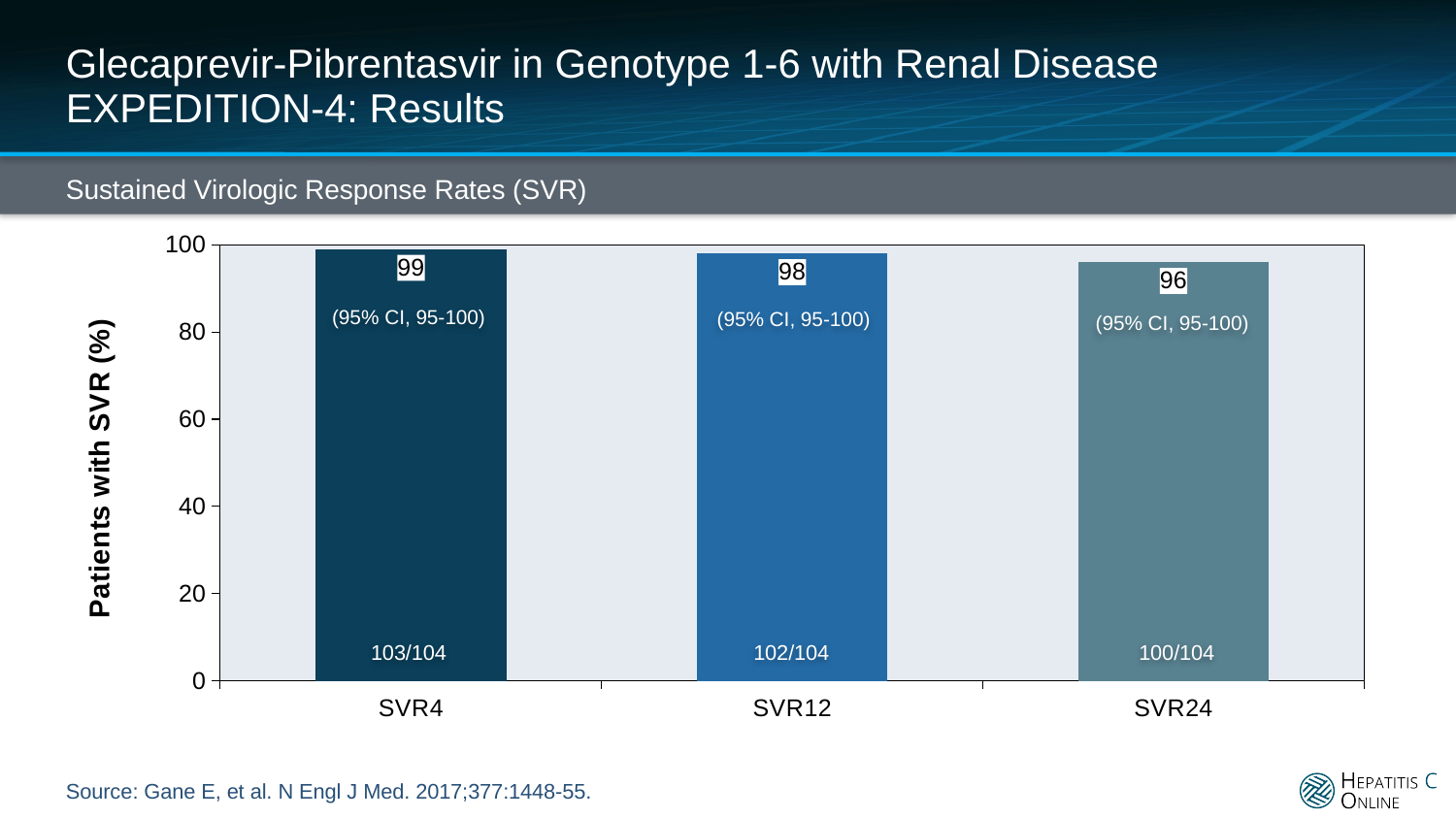
What is the y-axis label of the chart? Patients with SVR (%) Which category has the highest value? SVR4 What is the value for SVR4? 99 Which category has the lowest value? SVR24 Which is larger, the value for SVR12 or the value for SVR24? SVR12 How many categories are shown on the x axis? 3 Is the value for SVR24 greater or less than 80? greater What is the difference between the values for SVR4 and SVR24? 3 What is the value for SVR12? 98 What is the value for SVR24? 96 Do the values rise or fall from SVR4 to SVR24? fall What kind of chart is shown? bar chart